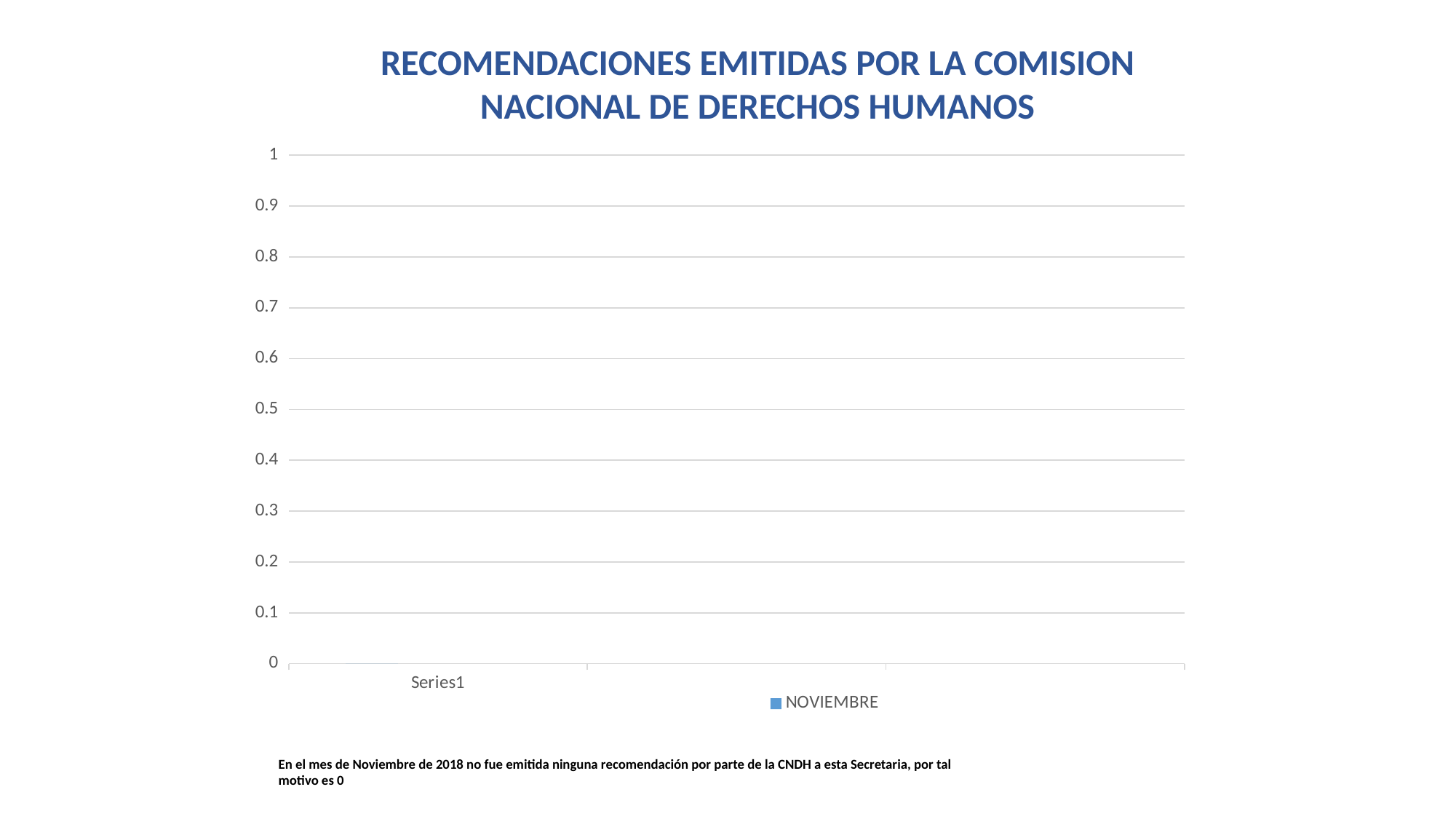
What is the title of the chart? RECOMENDACIONES EMITIDAS POR LA COMISION NACIONAL DE DERECHOS HUMANOS What series name appears in the chart legend? NOVIEMBRE How many categories are shown on the x axis of the chart? 1 How many series does the chart legend list? 1 What is the value for Series1 in the NOVIEMBRE series? 0 Is the value for Series1 greater or less than 0.5? less What is the maximum value shown on the y axis of the chart? 1